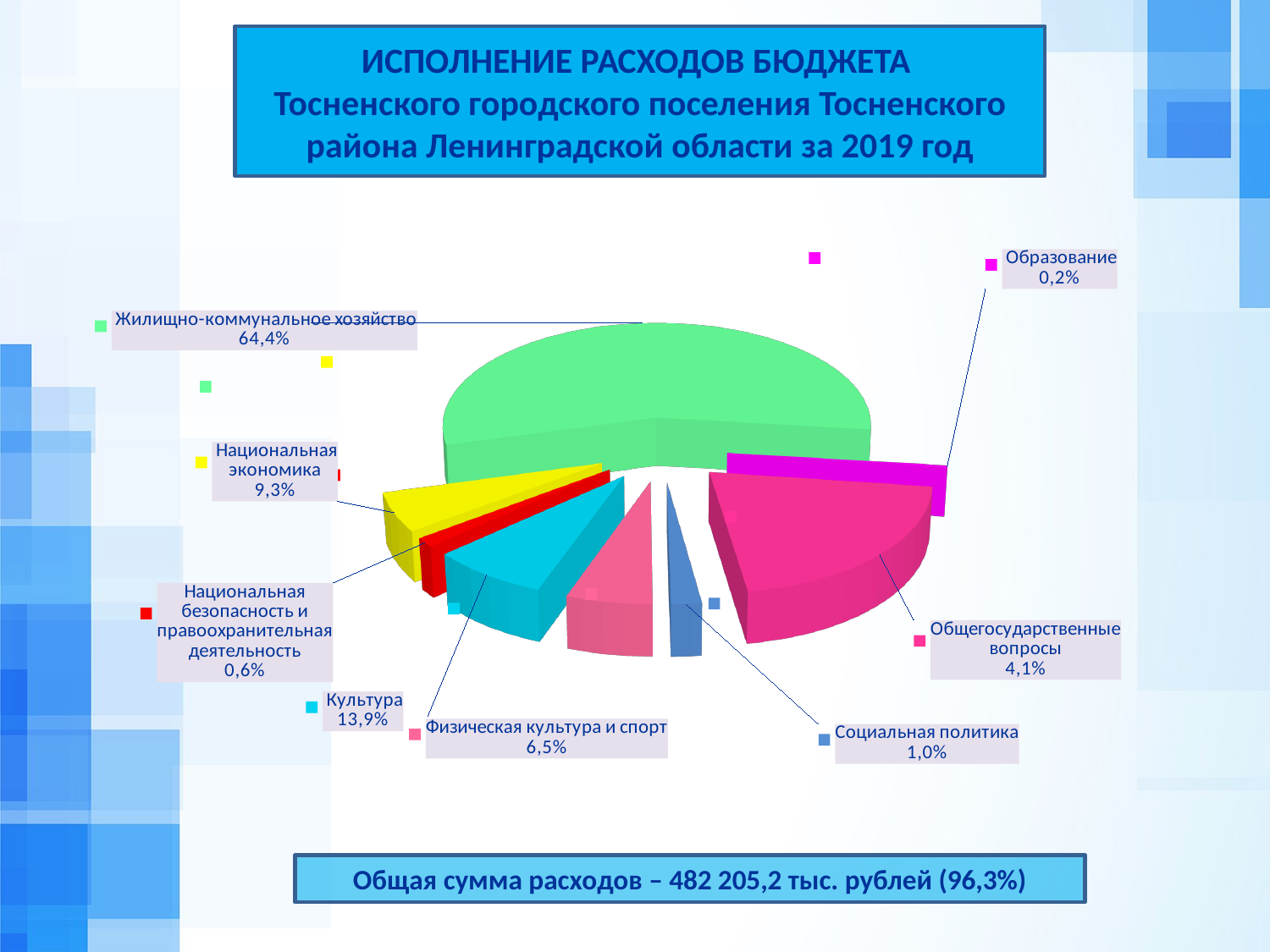
What is the value shown for Культура? 13,9% What share of the pie does Жилищно-коммунальное хозяйство represent? 64,4% What is the value shown for Социальная политика? 1,0% What is the difference between the shares of Культура and Национальная экономика? 4,6% How many categories are shown in the pie chart? 8 Which is larger: the share for Физическая культура и спорт or the share for Общегосударственные вопросы? Физическая культура и спорт What is the value shown for Физическая культура и спорт? 6,5% What is the value shown for Общегосударственные вопросы? 4,1% Which category has the largest share of the pie? Жилищно-коммунальное хозяйство What is the value shown for Национальная экономика? 9,3% Which category has the smallest share of the pie? Образование What type of chart is shown on the slide? Pie chart